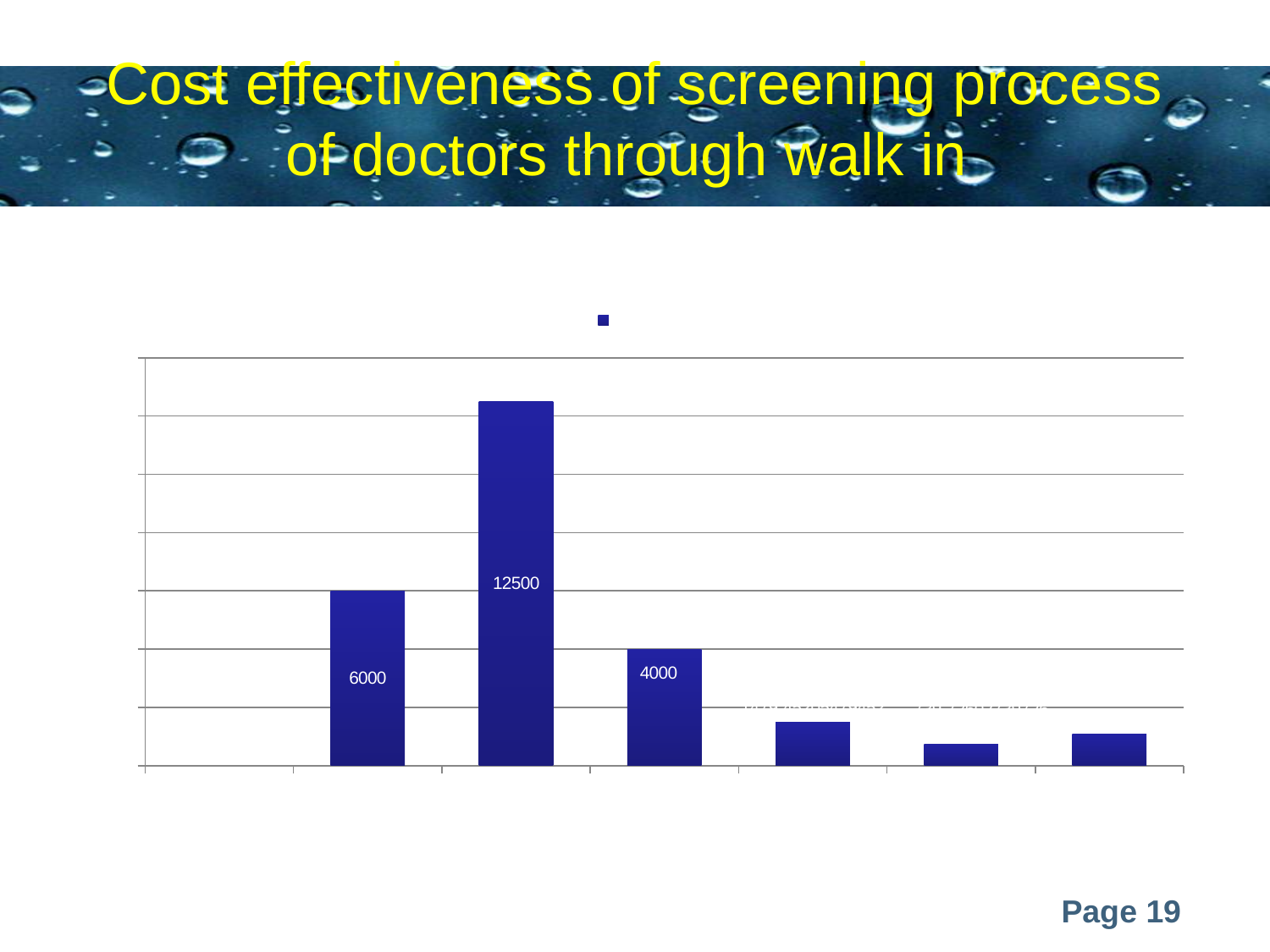
What kind of chart is shown on the slide? bar chart Which bar has the highest value in the chart? the second bar from the left (12500) What is the difference between the second bar (12500) and the first bar (6000)? 6500 What is the value shown on the third bar from the left? 4000 What is the value shown on the second bar from the left? 12500 What is the difference between the first bar (6000) and the third bar (4000)? 2000 How many bars are plotted in the chart? 6 Which is larger, the value of the first bar or the value of the third bar? the first bar (6000) Which is larger, the value of the second bar or the value of the third bar? the second bar (12500) What colour are the bars in the chart? dark blue What is the value shown on the first bar from the left? 6000 Do the values of the last three bars rise or fall compared with the first three bars? fall